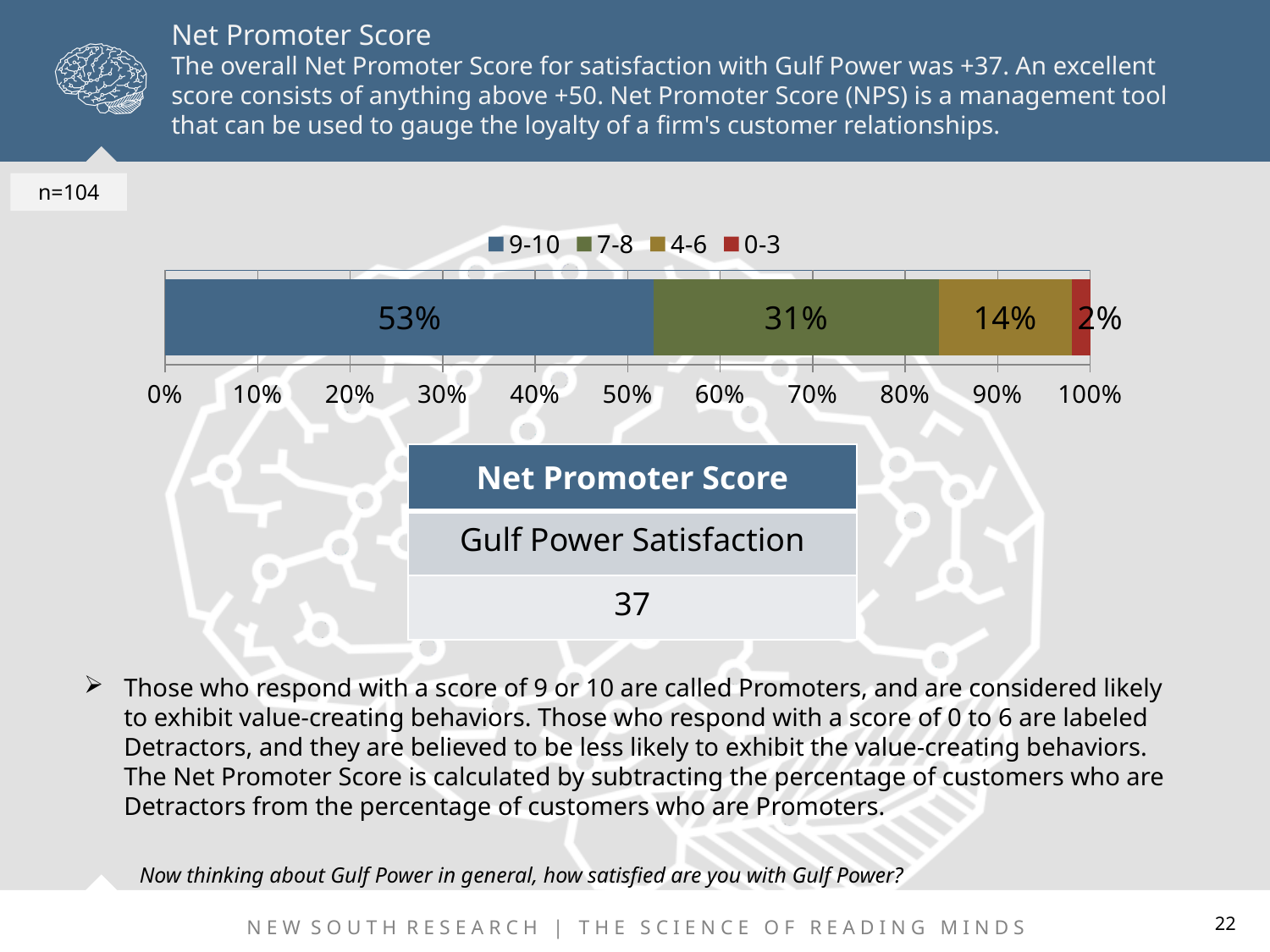
Which is larger, the share for 7-8 or the share for 4-6? 7-8 What kind of chart is shown on the slide? Stacked bar chart What is the sample size shown on the slide? n=104 What is the difference between the 9-10 share and the 7-8 share? 22% What percentage of respondents gave a score of 7-8? 31% What percentage of respondents gave a score of 0-3? 2% How many series does the legend list? 4 What percentage of respondents gave a score of 4-6? 14% What percentage of respondents gave a score of 9-10? 53% Which score range has the smallest share of respondents? 0-3 Which score range has the largest share of respondents? 9-10 What is the total of the stacked bar? 100%